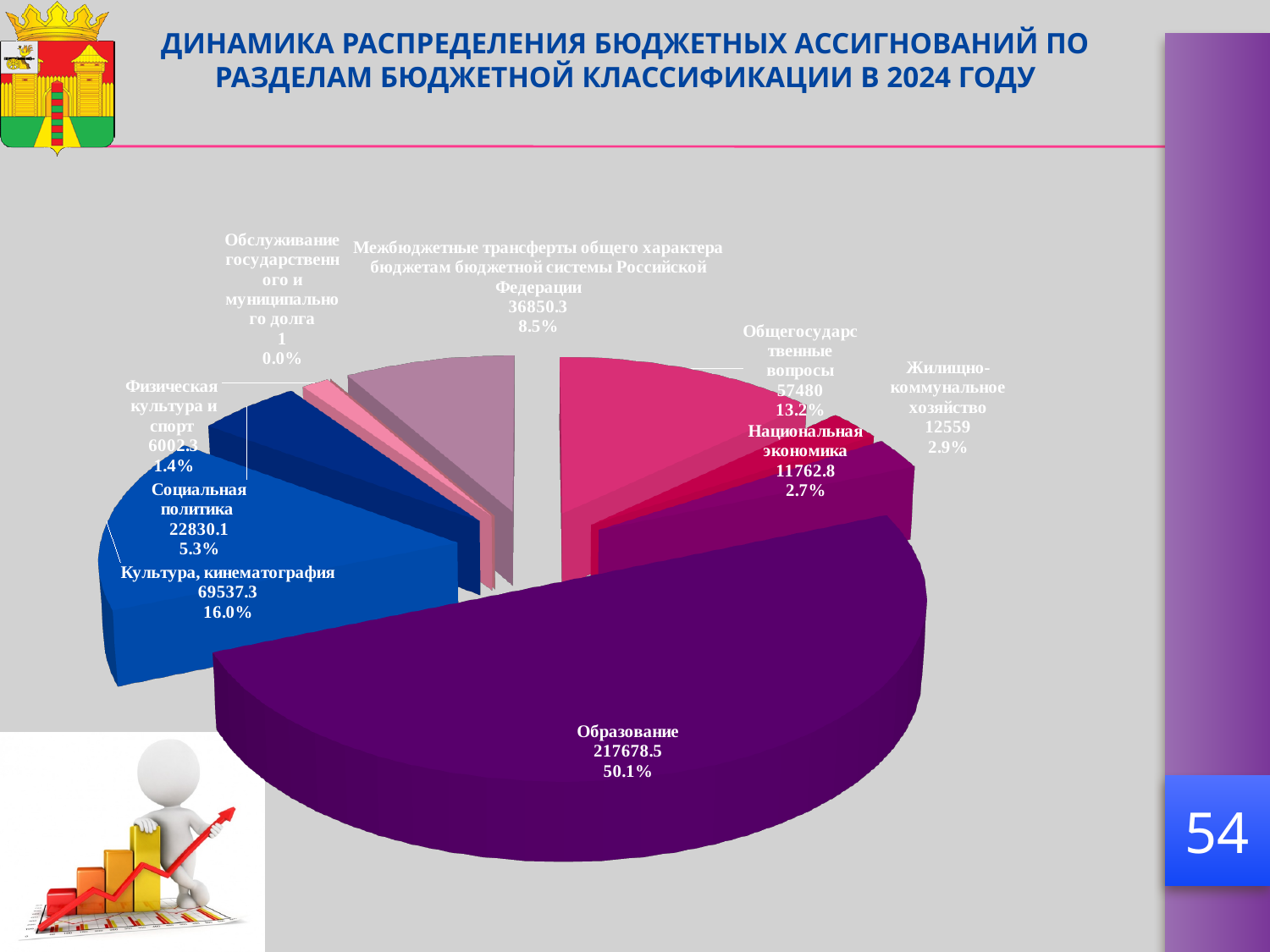
What value is shown for the Образование slice? 217678.5 What value is shown for Национальная экономика? 11762.8 What share of the pie does Образование represent? 50.1% What value is shown for Культура, кинематография? 69537.3 Which category has the largest slice of the pie? Образование Which is larger: Социальная политика or Жилищно-коммунальное хозяйство? Социальная политика What is the difference between the values for Общегосударственные вопросы and Межбюджетные трансферты общего характера бюджетам бюджетной системы Российской Федерации? 20629.7 What percentage is shown for Общегосударственные вопросы? 13.2% How many categories are shown in the pie chart? 9 Which category has the smallest slice of the pie? Обслуживание государственного и муниципального долга What type of chart is shown on the slide? Pie chart What year does the chart title refer to? 2024